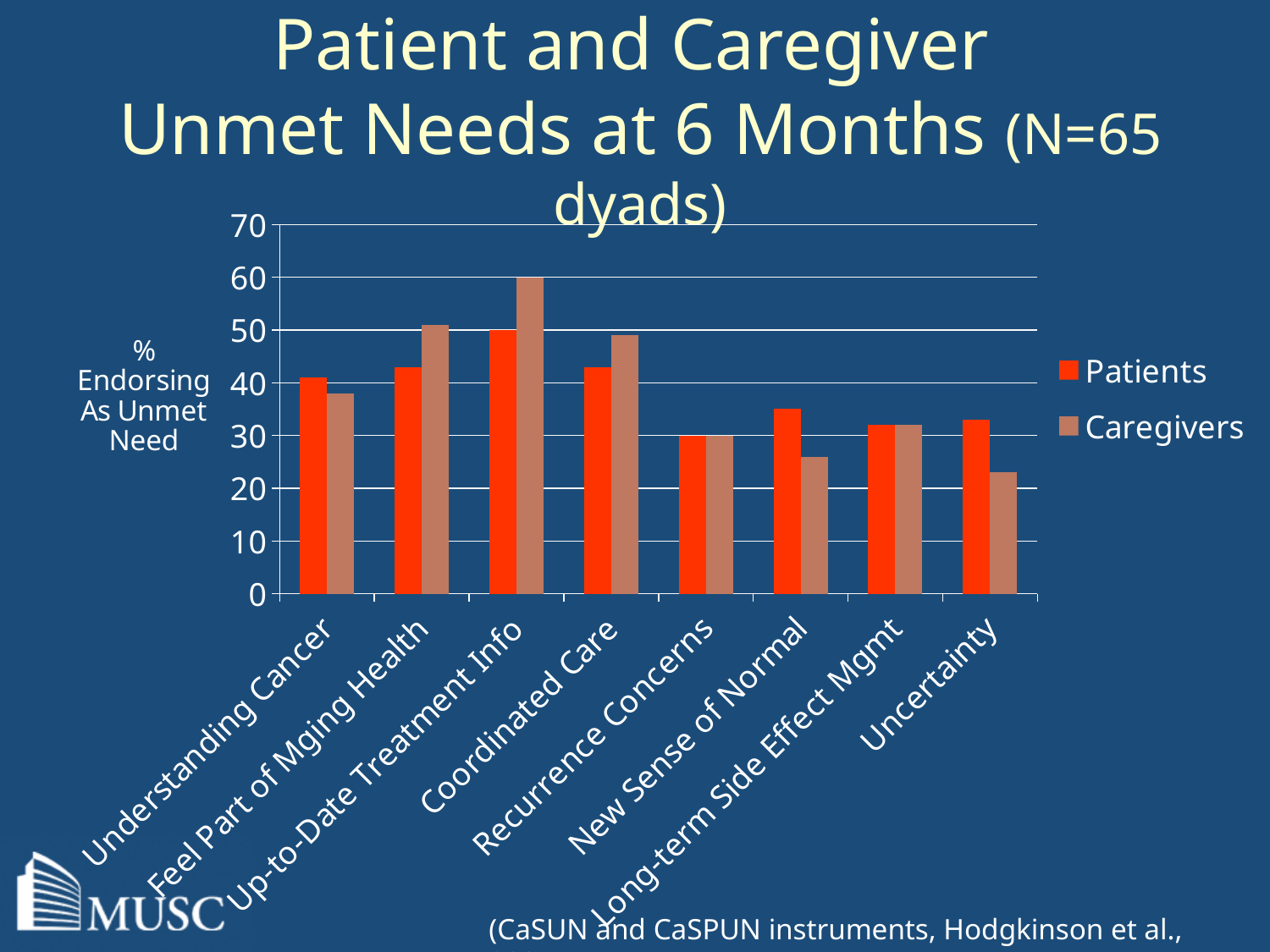
What is the Patients value for Up-to-Date Treatment Info? 50 What is the Caregivers value for Up-to-Date Treatment Info? 60 Which category has the highest Caregivers value? Up-to-Date Treatment Info For Uncertainty, which is larger: the Patients value or the Caregivers value? Patients How many categories are shown on the x axis? 8 How many series does the legend list? 2 What kind of chart is shown on the slide? bar chart What is the Patients value for Recurrence Concerns? 30 For Feel Part of Mging Health, which is larger: the Patients value or the Caregivers value? Caregivers Is the Caregivers value for New Sense of Normal greater or less than 30? less Which category has the lowest Caregivers value? Uncertainty